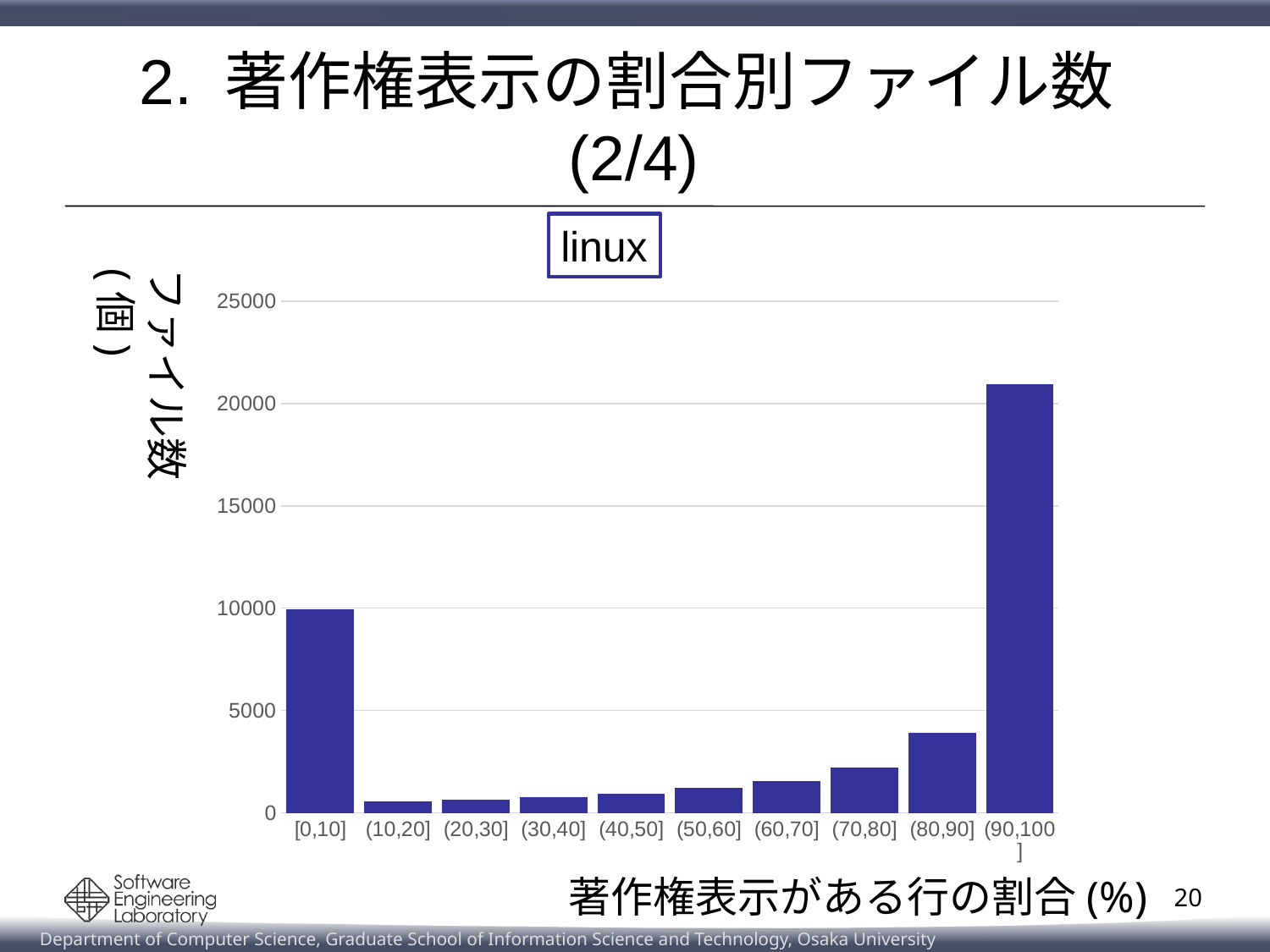
Is the value for (70,80] greater or less than 5000? less What is the title shown above the chart? linux Is the value for (80,90] greater or less than 5000? less Which is larger, the value for [0,10] or the value for (80,90]? [0,10] Which category has the highest number of files? (90,100] Which is larger, the value for (90,100] or the value for [0,10]? (90,100] Is the value for (90,100] greater or less than 20000? greater From (10,20] to (90,100], do the values rise or fall along the x axis? rise What kind of chart is shown on the slide? bar chart Which category has the lowest number of files? (10,20] How many categories (bins) are shown on the x axis of the chart? 10